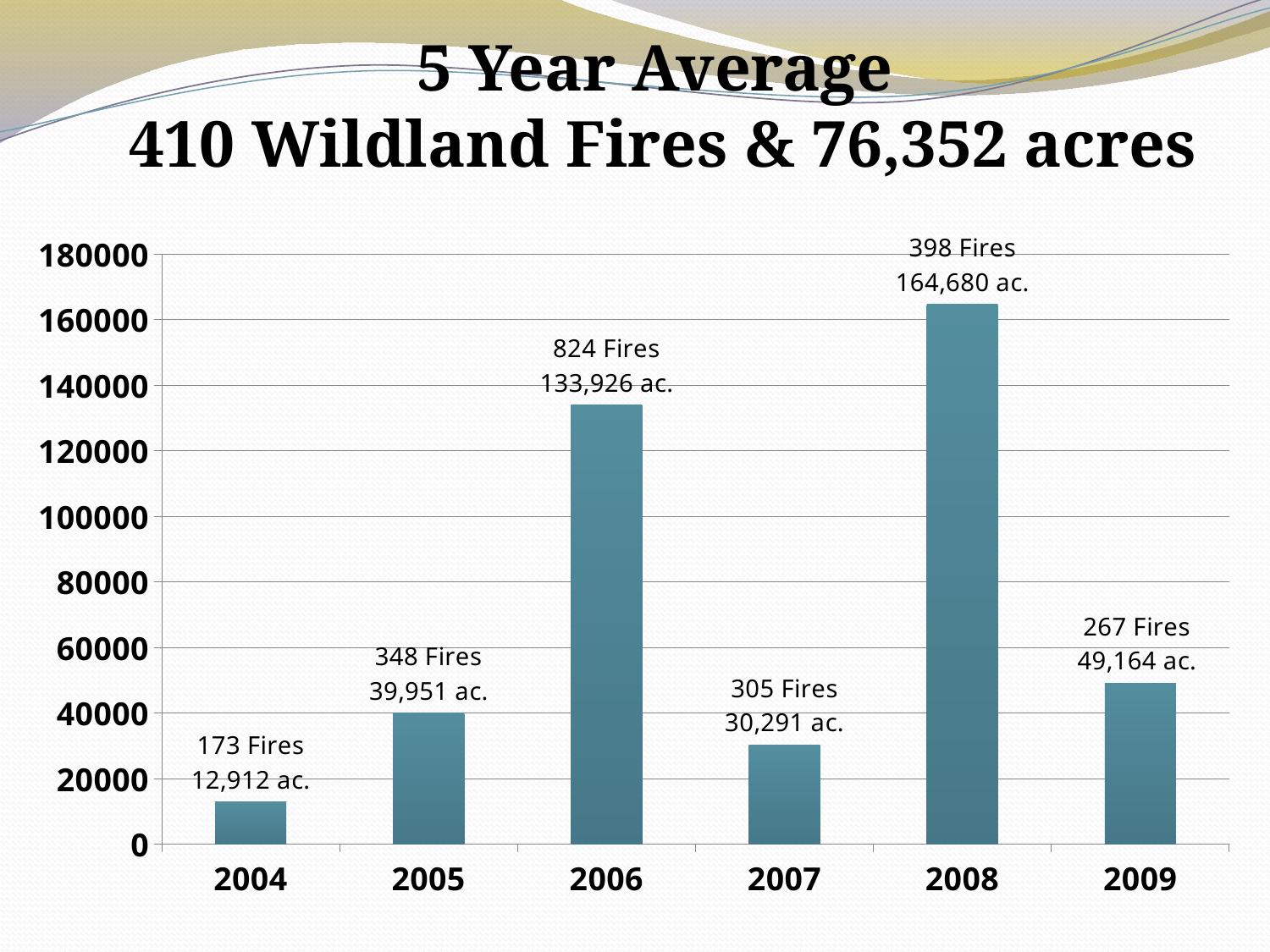
Is the value for 2009 greater or less than 40000? greater How many acres burned in 2006? 133,926 ac. What kind of chart is shown on the slide? bar chart How many acres burned in 2009? 49,164 ac. Which year had the most fires according to the data labels? 2006 What is the difference in acres burned between 2008 and 2006? 30,754 How many years are shown on the x axis? 6 Which year has the highest acreage burned? 2008 How many fires occurred in 2004? 173 Fires Which year had more acres burned, 2005 or 2007? 2005 What is the 5 year average number of wildland fires stated in the title? 410 Which year has the lowest acreage burned? 2004